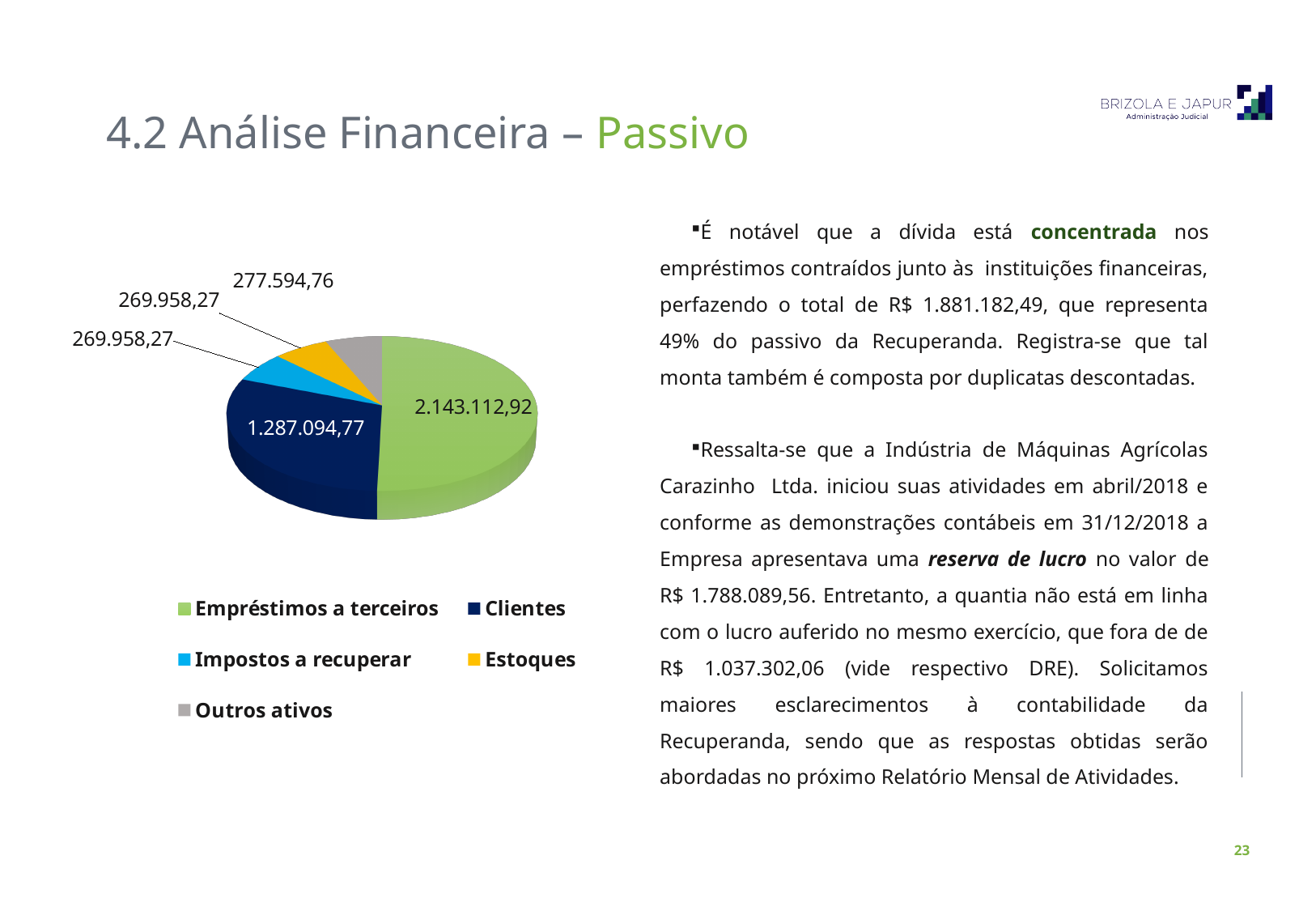
What is the value for Clientes in the pie chart? 1.287.094,77 What is the value for Empréstimos a terceiros in the pie chart? 2.143.112,92 Which category has the largest slice in the pie chart? Empréstimos a terceiros How many slices does the pie chart have? 5 What is the value for Estoques in the pie chart? 269.958,27 How many entries does the legend of the pie chart list? 5 What colour is the Clientes slice in the pie chart? dark blue What is the difference between the values for Empréstimos a terceiros and Clientes? 856.018,15 What type of chart is shown on the slide? pie chart What is the value for Outros ativos in the pie chart? 277.594,76 Which is larger, the value for Outros ativos or the value for Estoques? Outros ativos What is the value for Impostos a recuperar in the pie chart? 269.958,27